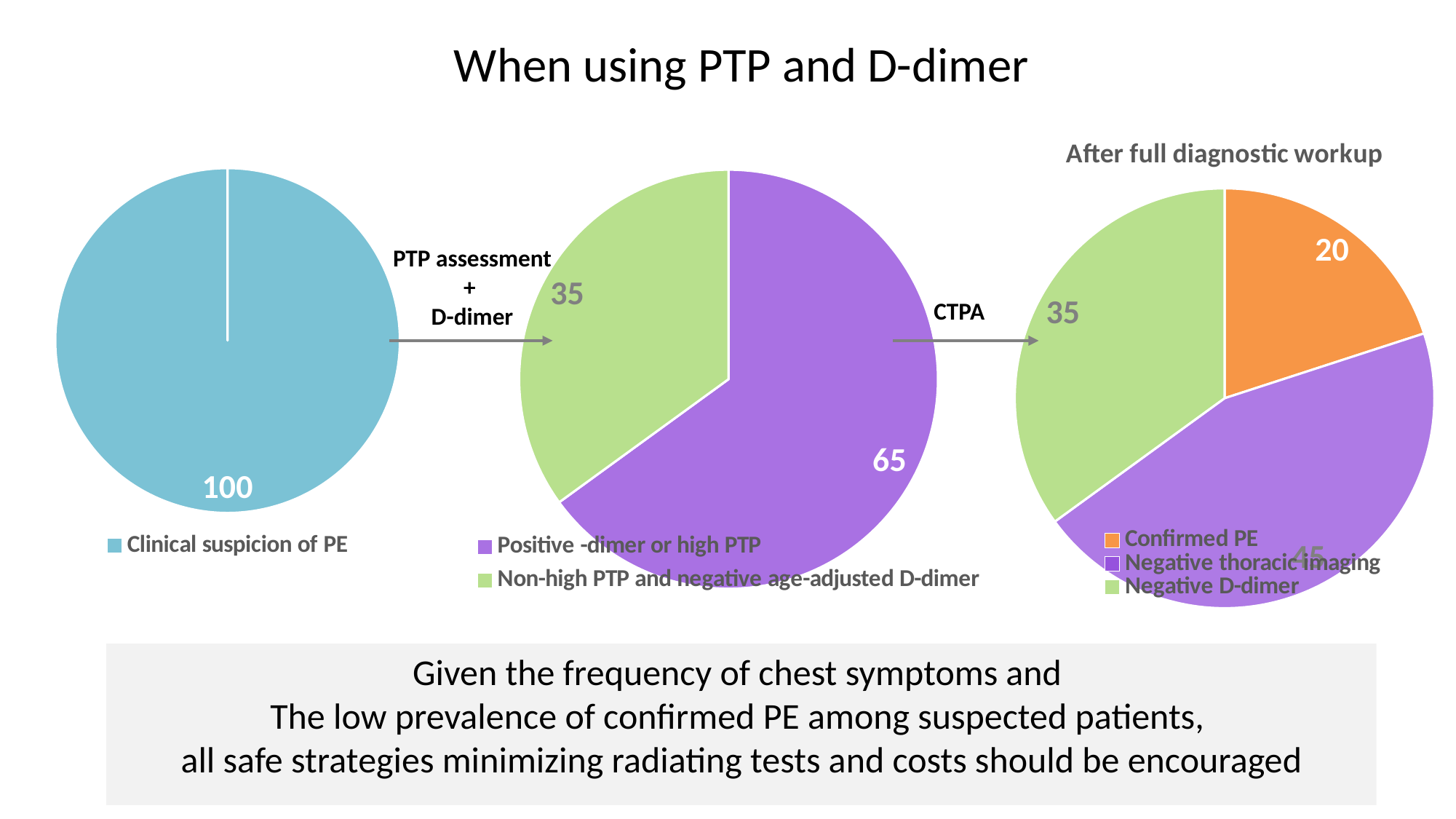
In the pie chart titled 'After full diagnostic workup', what value is shown for Negative thoracic imaging? 45 How many categories does the legend of the pie chart titled 'After full diagnostic workup' list? 3 In the pie chart titled 'After full diagnostic workup', what value is shown for Confirmed PE? 20 What kind of charts are shown on the slide? Pie charts In the middle pie chart, what is the difference between the Positive D-dimer or high PTP slice and the Non-high PTP and negative age-adjusted D-dimer slice? 30 In the pie chart titled 'After full diagnostic workup', what colour is the Confirmed PE slice? Orange In the left pie chart, what value is shown for Clinical suspicion of PE? 100 In the middle pie chart, which slice is larger: Positive D-dimer or high PTP, or Non-high PTP and negative age-adjusted D-dimer? Positive D-dimer or high PTP In the pie chart titled 'After full diagnostic workup', which category has the smallest slice? Confirmed PE In the middle pie chart, what value is shown for Non-high PTP and negative age-adjusted D-dimer? 35 In the pie chart titled 'After full diagnostic workup', which category has the largest slice? Negative thoracic imaging In the middle pie chart, what value is shown for Positive D-dimer or high PTP? 65